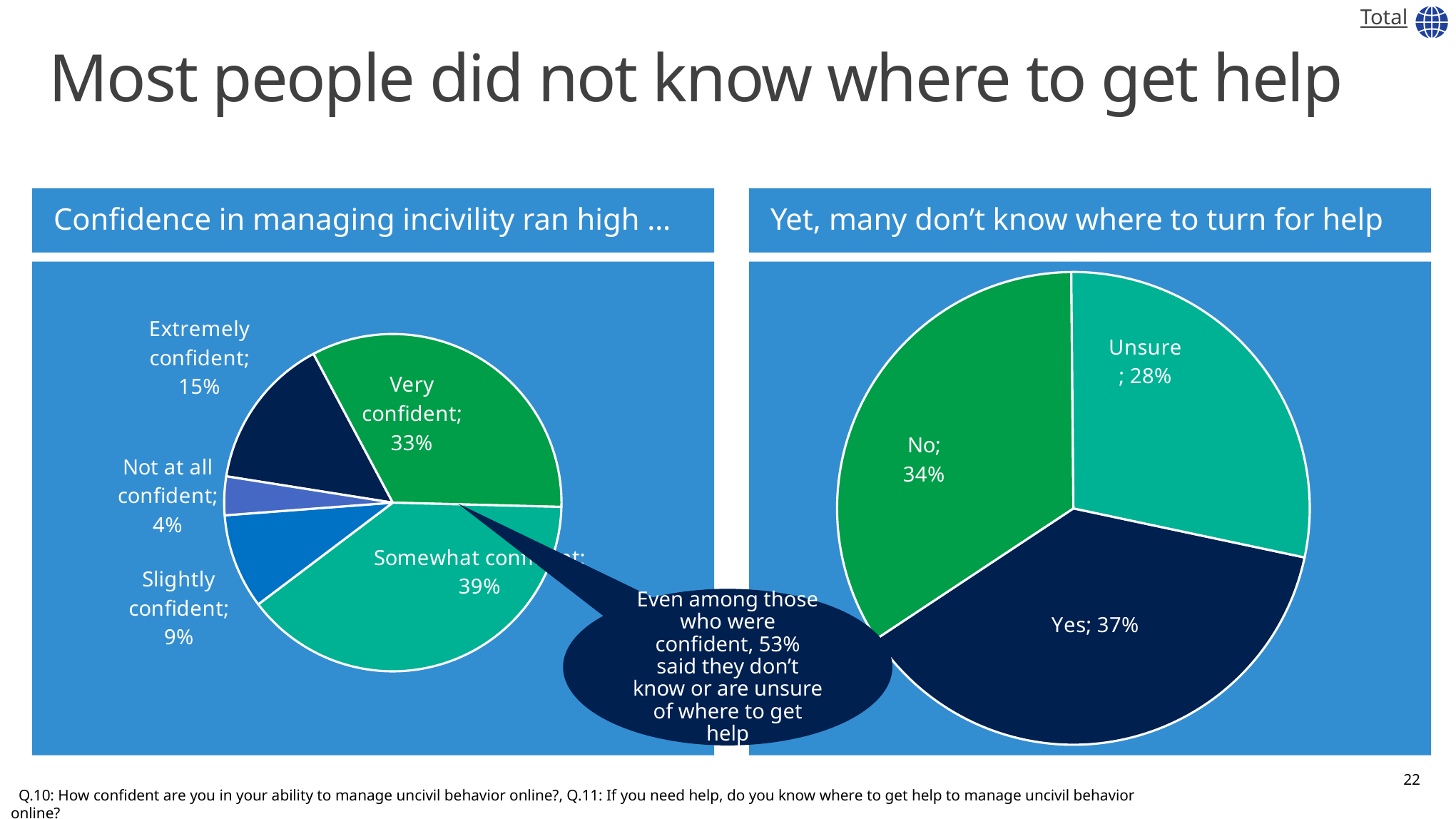
In the left chart 'Confidence in managing incivility ran high …', what share is Not at all confident? 4% In the right chart 'Yet, many don't know where to turn for help', what share answered Yes? 37% In the left chart 'Confidence in managing incivility ran high …', what share is Somewhat confident? 39% In the right chart 'Yet, many don't know where to turn for help', which is larger, No or Unsure? No In the right chart 'Yet, many don't know where to turn for help', what share answered Unsure? 28% In the left chart 'Confidence in managing incivility ran high …', which category has the largest slice? Somewhat confident In the left chart 'Confidence in managing incivility ran high …', which category has the smallest slice? Not at all confident In the left chart 'Confidence in managing incivility ran high …', what is the difference between Extremely confident and Slightly confident? 6 percentage points In the right chart 'Yet, many don't know where to turn for help', what is the difference between Yes and No? 3 percentage points In the left chart 'Confidence in managing incivility ran high …', how many categories are shown? 5 What kind of chart is the right chart 'Yet, many don't know where to turn for help'? Pie chart In the left chart 'Confidence in managing incivility ran high …', what share is Very confident? 33%